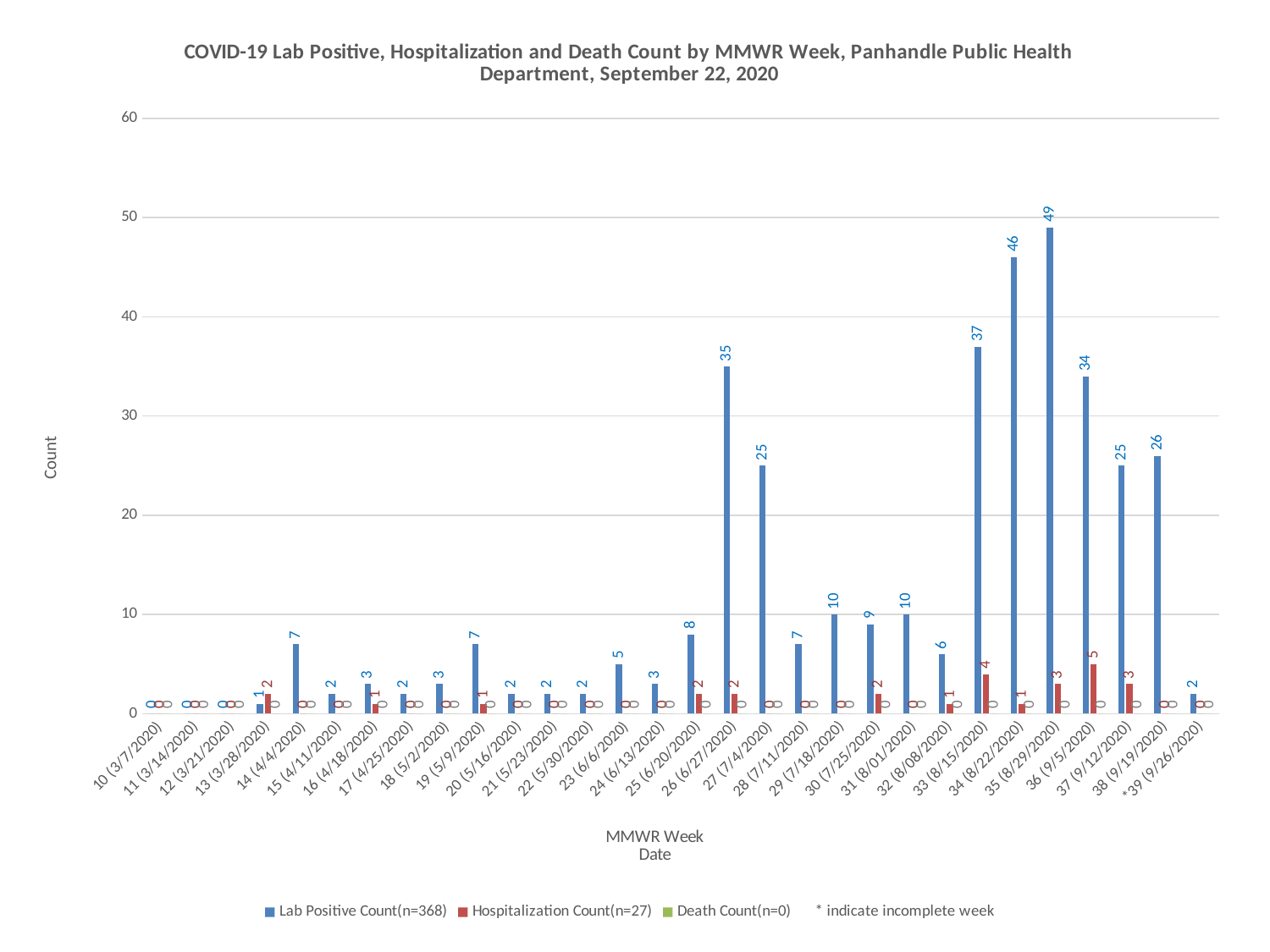
What is the Hospitalization Count for MMWR week 36 (9/5/2020)? 5 Which is larger, the Lab Positive Count for week 33 (8/15/2020) or week 36 (9/5/2020)? 33 (8/15/2020) How many MMWR weeks are shown on the x axis? 30 Is the Lab Positive Count for week 34 (8/22/2020) greater or less than 40? greater Which MMWR week has the highest Hospitalization Count? 36 (9/5/2020) How many series does the legend list? 3 What is the Lab Positive Count for MMWR week 26 (6/27/2020)? 35 What is the Lab Positive Count for MMWR week 35 (8/29/2020)? 49 Which MMWR week has the highest Lab Positive Count? 35 (8/29/2020) According to the legend, what is the total n for the Hospitalization Count series? 27 What is the difference between the Lab Positive Count for week 35 (8/29/2020) and week 34 (8/22/2020)? 3 What kind of chart is shown on the slide? bar chart